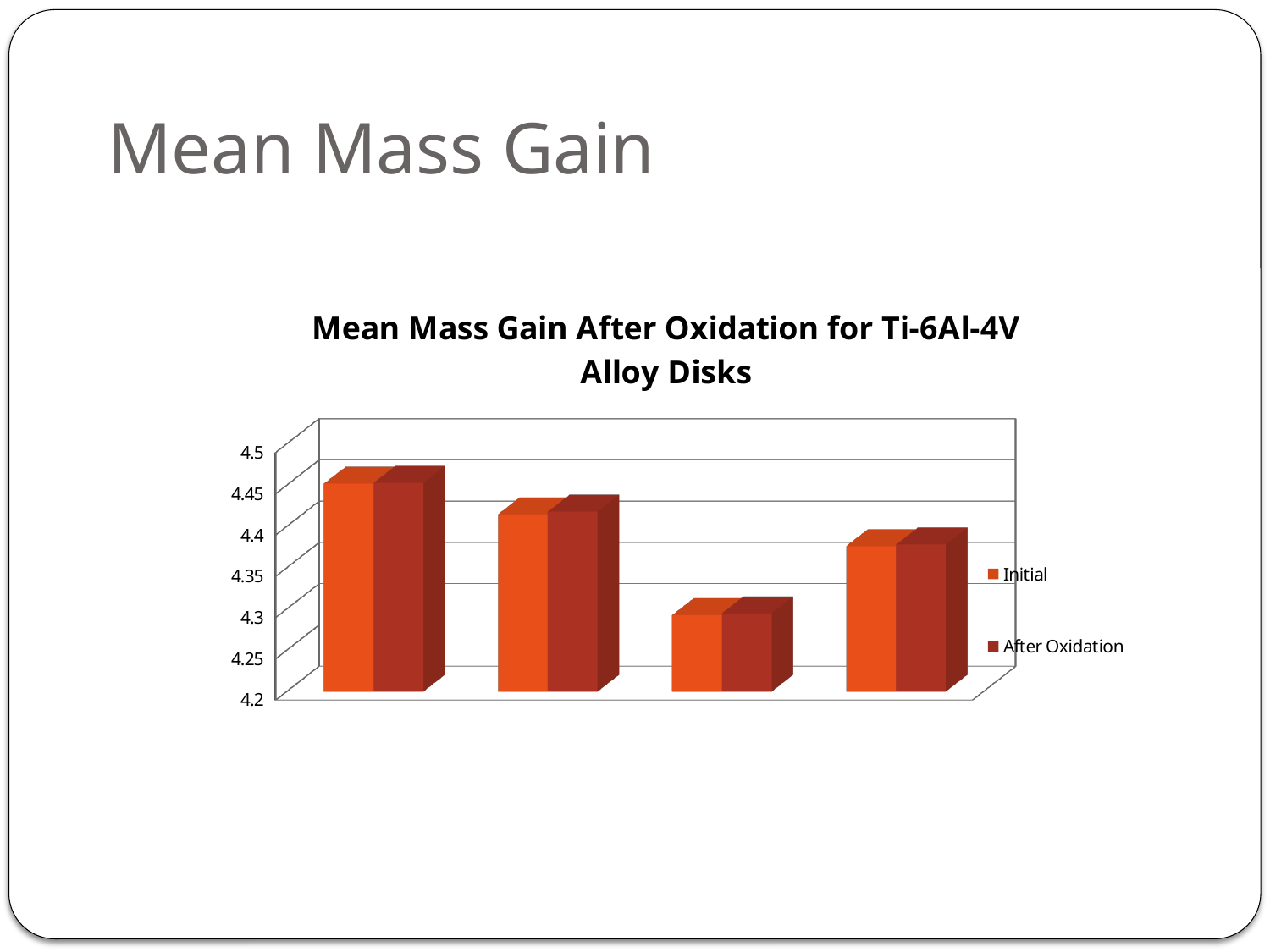
Is the After Oxidation value for the fourth group from the left greater or less than 4.3? greater Which group of bars, counting from the left, is the tallest? the first group What are the two series named in the legend? Initial and After Oxidation Which group of bars, counting from the left, is the shortest? the third group Is the Initial value for the first group from the left greater or less than 4.4? greater Is the Initial value for the third group from the left greater or less than 4.35? less How many groups of bars are plotted in the chart? 4 How many series does the legend list? 2 Which is larger, the Initial value for the first group from the left or the Initial value for the third group from the left? the first group What kind of chart is shown on the slide? bar chart What is the title of the chart? Mean Mass Gain After Oxidation for Ti-6Al-4V Alloy Disks